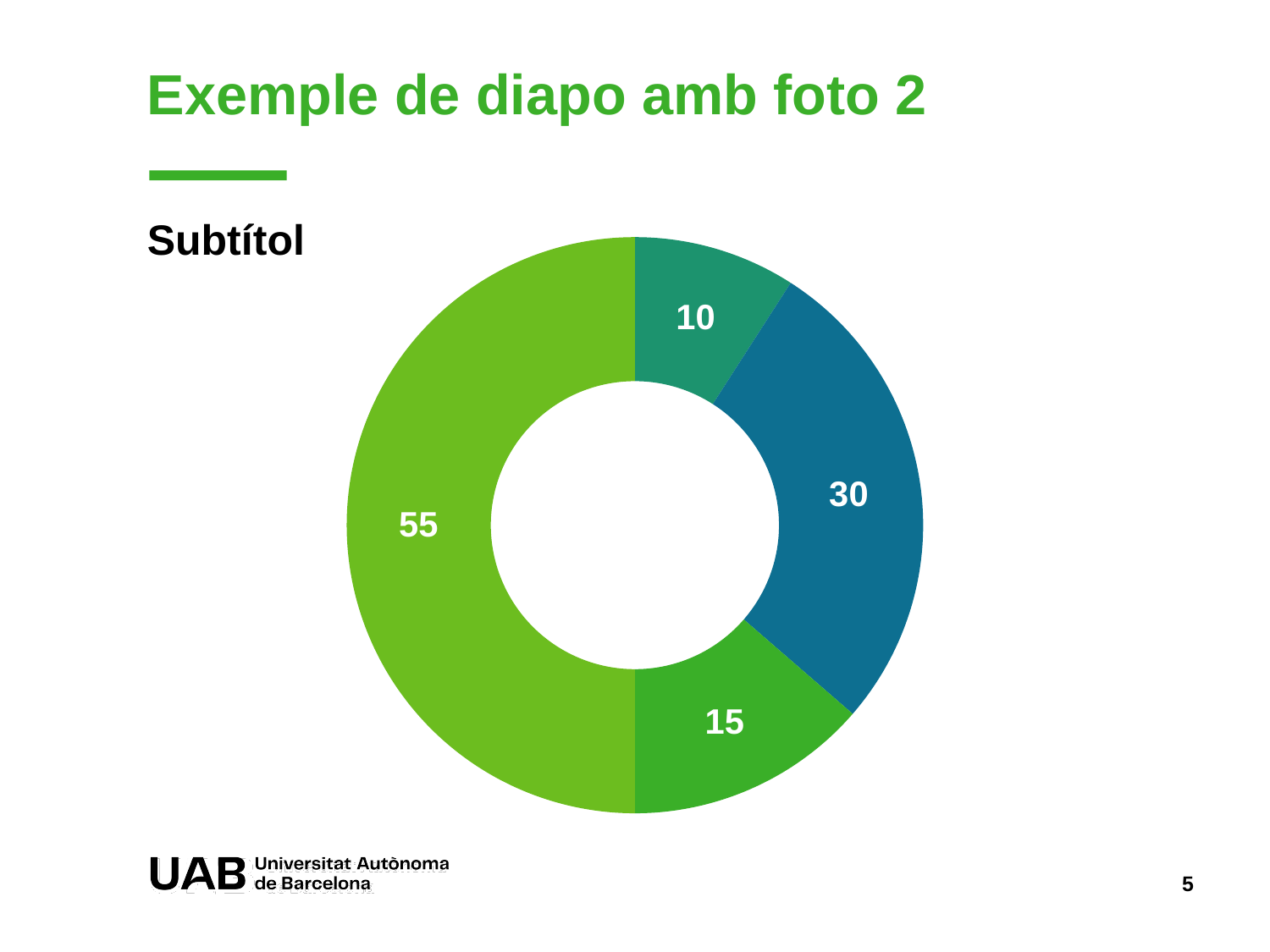
What colour is the largest slice of the doughnut chart? light green What value is shown on the green slice at the bottom of the doughnut chart? 15 What is the value of the smallest slice in the doughnut chart? 10 What is the difference between the largest slice (55) and the dark blue slice (30)? 25 What share of the total does the slice labelled 55 represent? 50% What is the total of all the slice values in the doughnut chart? 110 What value is shown on the dark blue slice of the doughnut chart? 30 Which is larger, the dark blue slice or the teal slice? the dark blue slice (30) What value is shown on the teal slice at the top of the doughnut chart? 10 What kind of chart is shown on the slide? doughnut chart What is the value of the largest slice in the doughnut chart? 55 How many slices does the doughnut chart have? 4